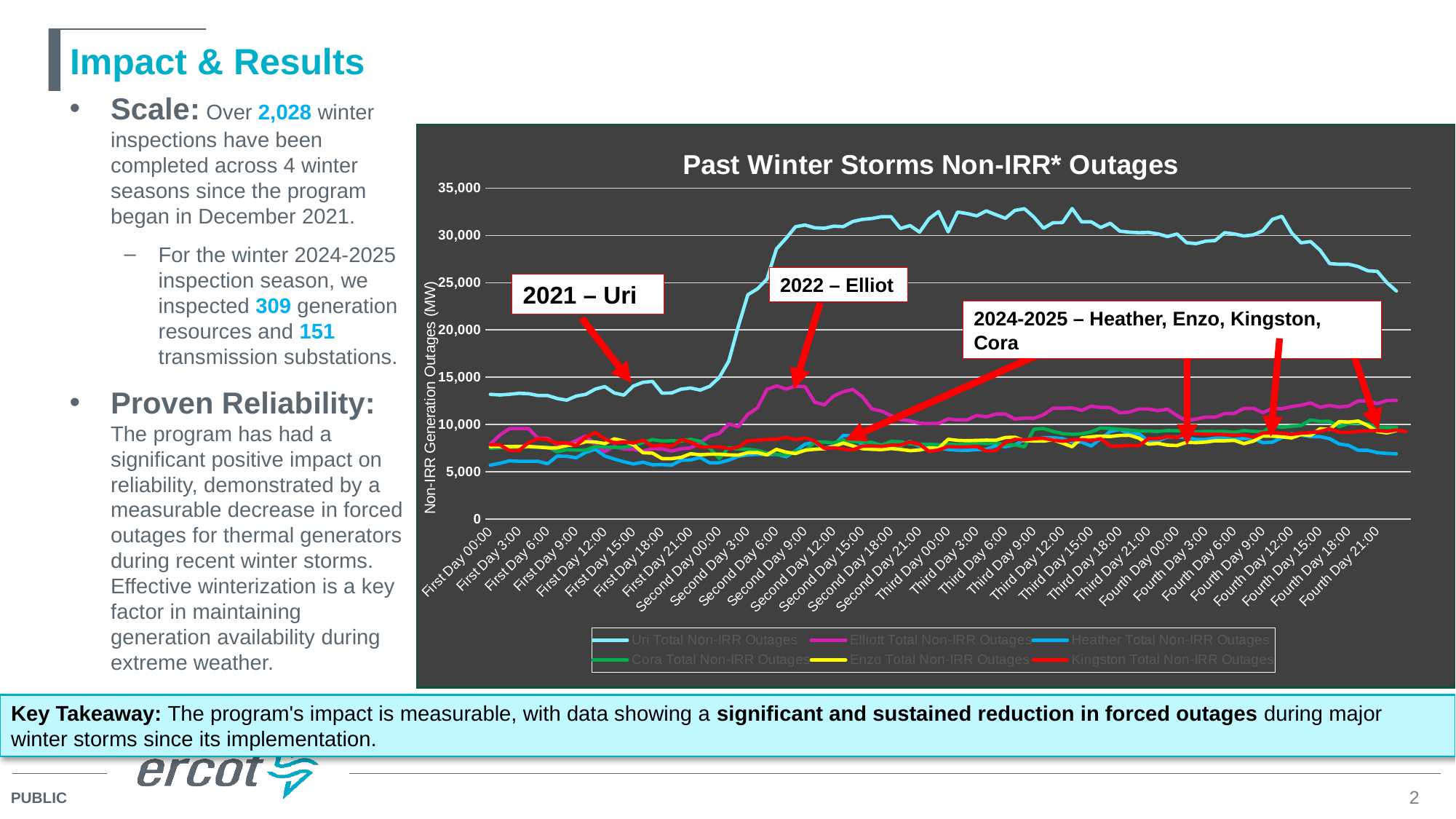
Does the Uri series rise or fall between Second Day 00:00 and Second Day 9:00? Rise Is the value of the Heather series at Fourth Day 21:00 greater or less than 10,000? less How many time labels are shown along the x axis of the chart? 32 What is the title of the chart? Past Winter Storms Non-IRR* Outages What kind of chart is shown on the slide? Line chart Is the value of the Uri series at Third Day 12:00 greater or less than 30,000? greater Which series reaches the highest value on the chart? Uri Total Non-IRR Outages Is the value of the Elliott series at Second Day 9:00 greater or less than 10,000? greater At Third Day 12:00, which is larger: the Uri series or the Heather series? Uri What is the label of the vertical axis of the chart? Non-IRR Generation Outages (MW) How many series does the legend of the chart list? 6